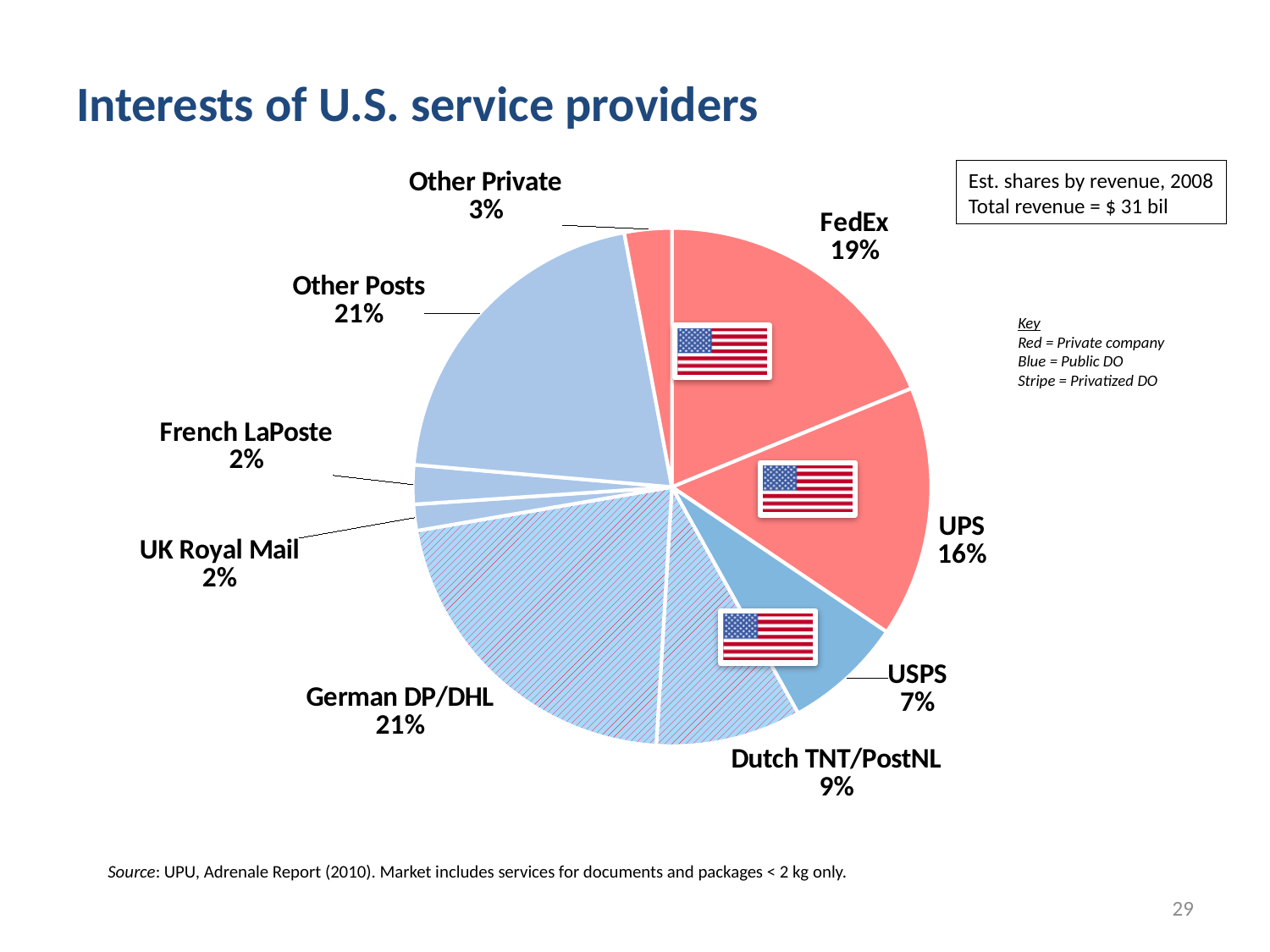
What is the share shown for UPS? 16% What kind of chart is shown on the slide? Pie chart What share is shown for Other Private? 3% What share is shown for USPS? 7% Which has the larger share, FedEx or UPS? FedEx How many percentage points larger is FedEx's share than UPS's share? 3 What share does Dutch TNT/PostNL have in the pie chart? 9% Which has the larger share, USPS or Dutch TNT/PostNL? Dutch TNT/PostNL What share of the pie does FedEx hold? 19% According to the key, what does a red slice represent? Private company How many slices does the pie chart have? 9 What share is shown for German DP/DHL? 21%